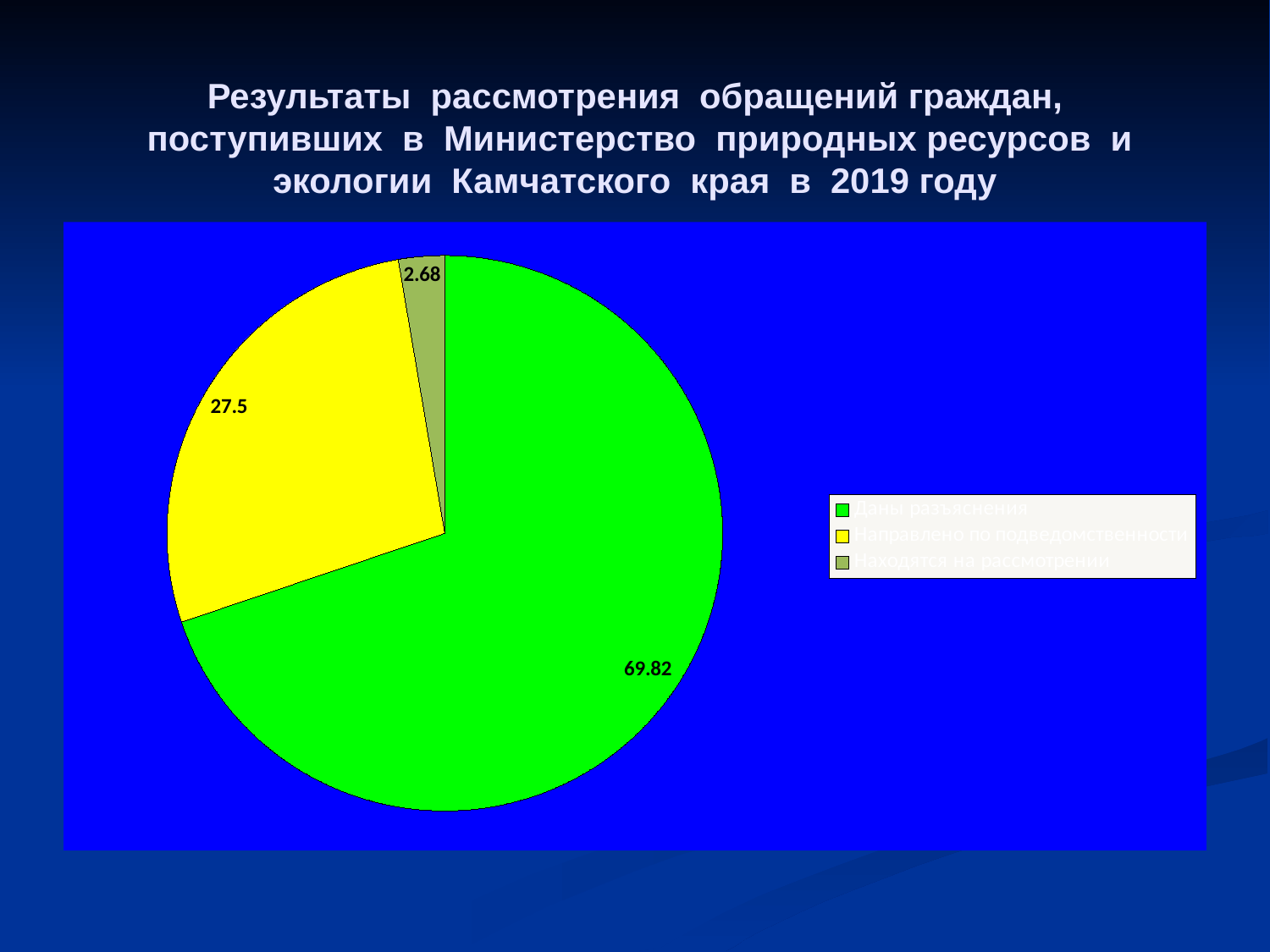
How many entries does the legend list? 3 Which is larger: the value for Направлено по подведомственности or the value for Находятся на рассмотрении? Направлено по подведомственности What is the value shown for the yellow slice (Направлено по подведомственности)? 27.5 How many slices does the pie chart have? 3 Which category has the smallest slice of the pie? Находятся на рассмотрении What is the value shown for the green slice (Даны разъяснения)? 69.82 What is the value shown for the slice labelled Находятся на рассмотрении? 2.68 Which category has the largest slice of the pie? Даны разъяснения What colour is the slice for Направлено по подведомственности? yellow What kind of chart is shown on the slide? pie chart Which legend entry is shown in green? Даны разъяснения What is the difference between the values for Даны разъяснения and Направлено по подведомственности? 42.32